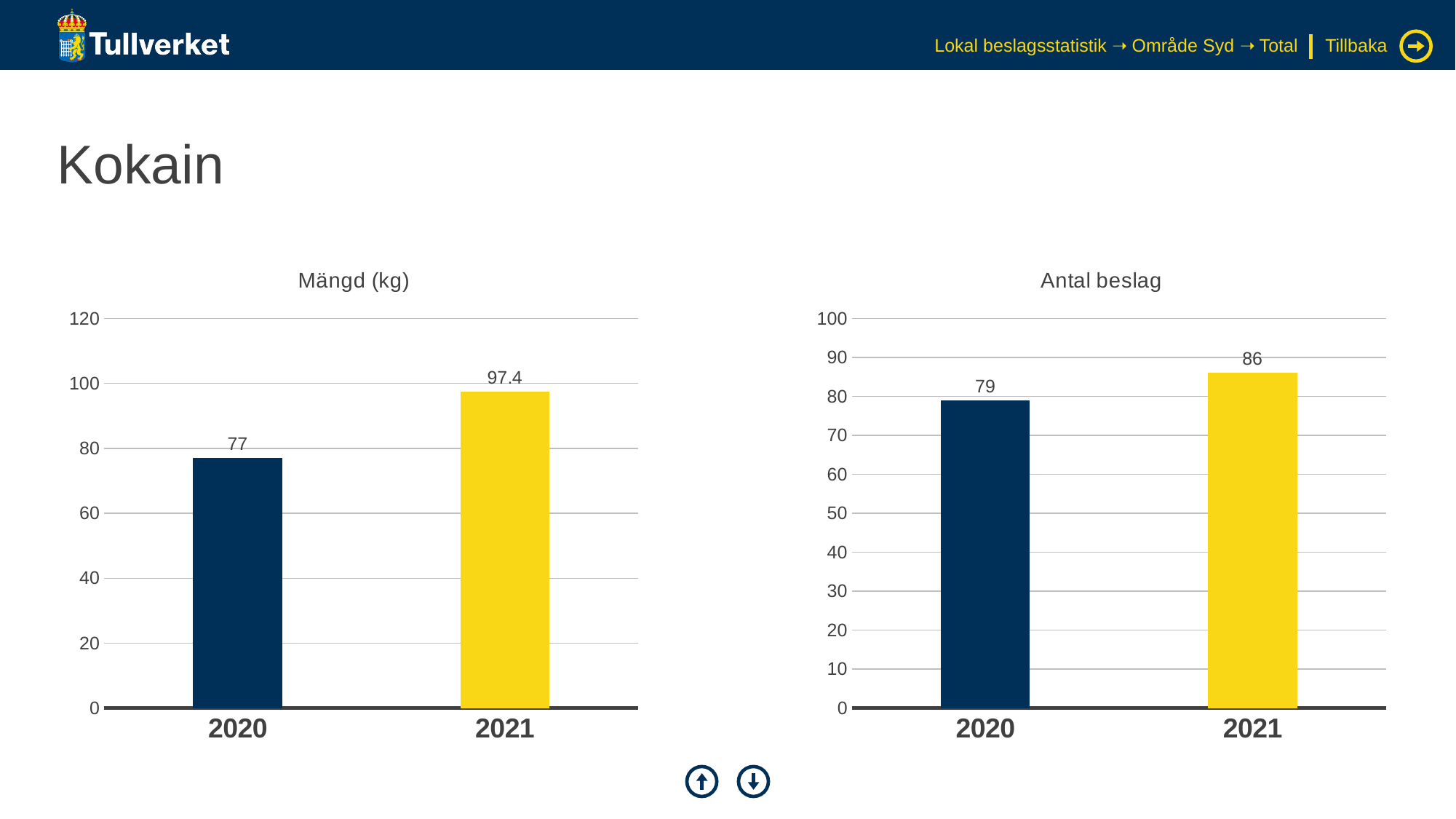
In the 'Antal beslag' chart, which year has the lowest value? 2020 How many categories are shown on the x axis of the 'Mängd (kg)' chart? 2 In the 'Mängd (kg)' chart, what is the value for 2021? 97.4 In the 'Antal beslag' chart, what is the difference between the 2021 and 2020 values? 7 What kind of chart is the 'Antal beslag' chart? bar chart In the 'Antal beslag' chart, is the value for 2020 greater or less than 80? less In the 'Antal beslag' chart, what is the value for 2021? 86 In the 'Mängd (kg)' chart, what is the difference between the 2021 and 2020 values? 20.4 In the 'Mängd (kg)' chart, do the values rise or fall from 2020 to 2021? rise In the 'Antal beslag' chart, what is the value for 2020? 79 In the 'Mängd (kg)' chart, what is the value for 2020? 77 In the 'Mängd (kg)' chart, which year has the highest value? 2021